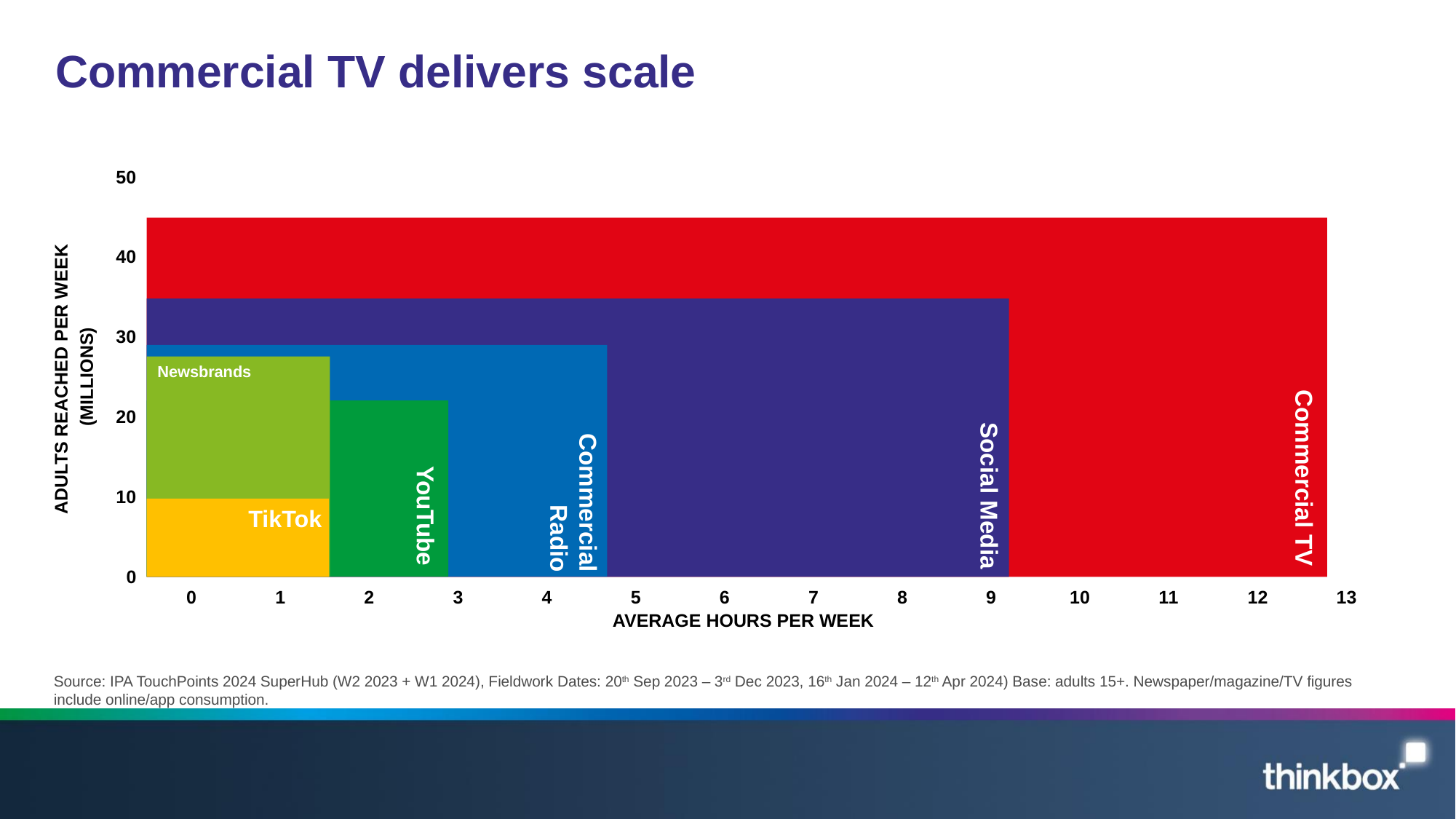
What is the label of the x axis of the chart? AVERAGE HOURS PER WEEK How many media categories are labelled in the chart? 6 Which media category reaches the most adults per week? Commercial TV Is the number of adults reached per week by Social Media greater or less than 30 million? greater Is the number of adults reached per week by TikTok greater or less than 20 million? less Which reaches more adults per week, Social Media or Commercial Radio? Social Media Is the number of adults reached per week by Commercial TV greater or less than 40 million? greater Which media category reaches the fewest adults per week? TikTok What kind of chart is shown on the slide? bar chart What is the title of the chart on the slide? Commercial TV delivers scale